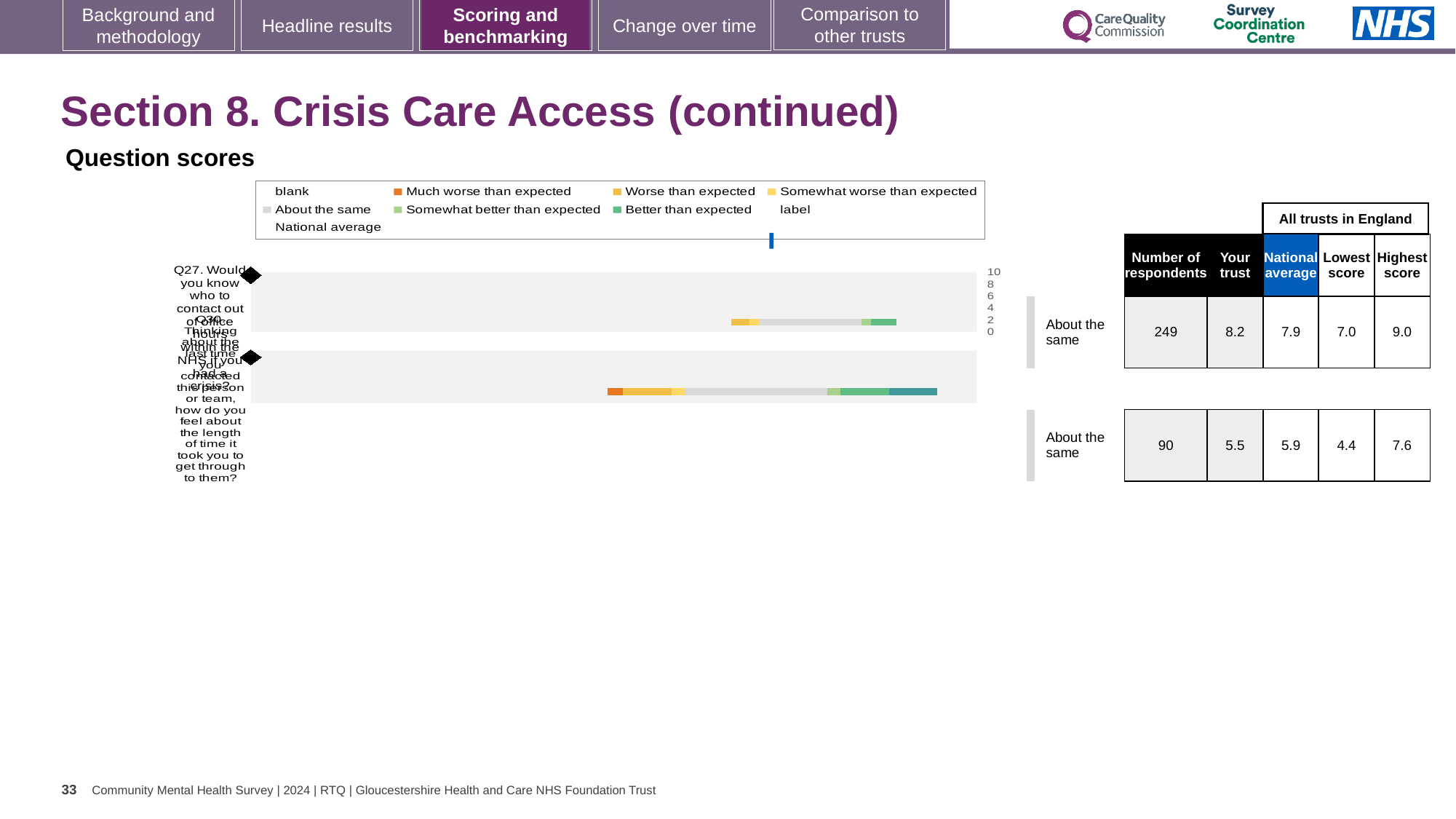
How many questions are plotted in the question scores chart? 2 What is the national average score for Q30? 5.9 What benchmark category is shown for Q30 in the question scores chart? About the same What kind of chart is used to show the question scores on this slide? bar chart What is the lowest score across all trusts in England for Q27? 7.0 What is the difference between the highest and lowest scores for Q30? 3.2 Which question has the higher 'Your trust' score, Q27 or Q30? Q27 What is the 'Your trust' score for Q27 in the question scores table? 8.2 For Q27, which is larger: the 'Your trust' score or the national average? Your trust For Q30, which is larger: the 'Your trust' score or the national average? National average What is the highest score across all trusts in England for Q30? 7.6 How many respondents answered Q27? 249